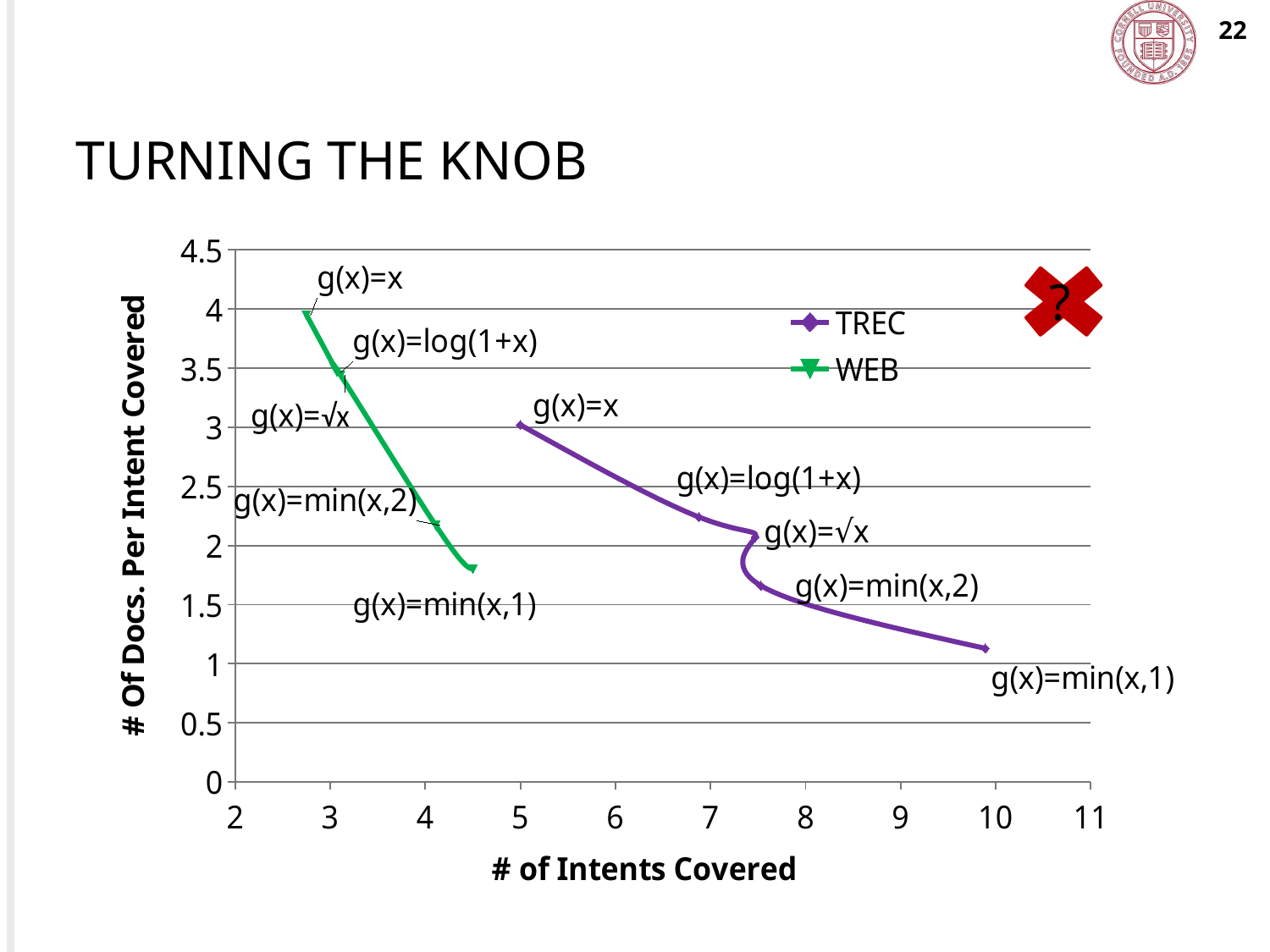
How many series does the legend list? 2 Is the # of Docs. Per Intent Covered for the WEB point labelled g(x)=x greater or less than 3.5? greater Is the # of Docs. Per Intent Covered for the TREC point labelled g(x)=log(1+x) greater or less than 2? greater How many labelled points does the TREC series have? 5 Is the # of Intents Covered for the WEB point labelled g(x)=min(x,1) greater or less than 5? less What kind of chart is shown on the slide? line chart Which series reaches a higher # of Intents Covered, TREC or WEB? TREC For each series, does the # of Docs. Per Intent Covered rise or fall as the # of Intents Covered increases? fall What are the two series named in the legend? TREC and WEB What is the title of the x axis? # of Intents Covered